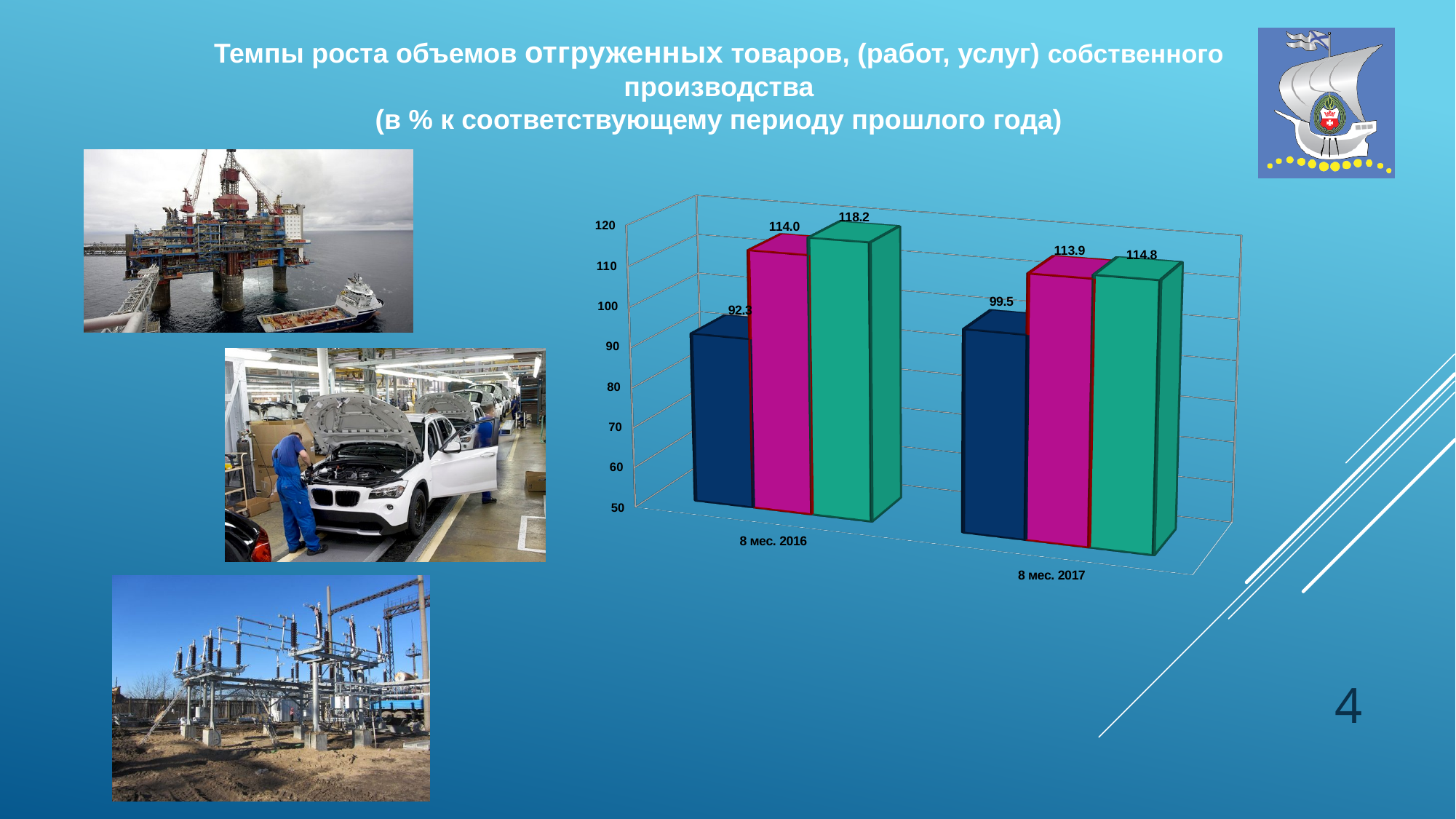
What is the value of the dark blue bar for 8 мес. 2017? 99.5 What is the value of the magenta bar for 8 мес. 2016? 114.0 Is the value of the dark blue bar for 8 мес. 2017 greater or less than 100? less What are the two category labels on the x axis of the chart? 8 мес. 2016 and 8 мес. 2017 What is the value of the teal (green) bar for 8 мес. 2016? 118.2 What is the value of the magenta bar for 8 мес. 2017? 113.9 Which is larger: the dark blue bar for 8 мес. 2016 or the dark blue bar for 8 мес. 2017? 8 мес. 2017 What is the difference between the teal bar values for 8 мес. 2016 and 8 мес. 2017? 3.4 How many categories (periods) are shown on the x axis of the chart? 2 Which bar has the highest value in the chart? the teal bar for 8 мес. 2016 (118.2) What is the value of the teal (green) bar for 8 мес. 2017? 114.8 What kind of chart is shown on the slide? bar chart